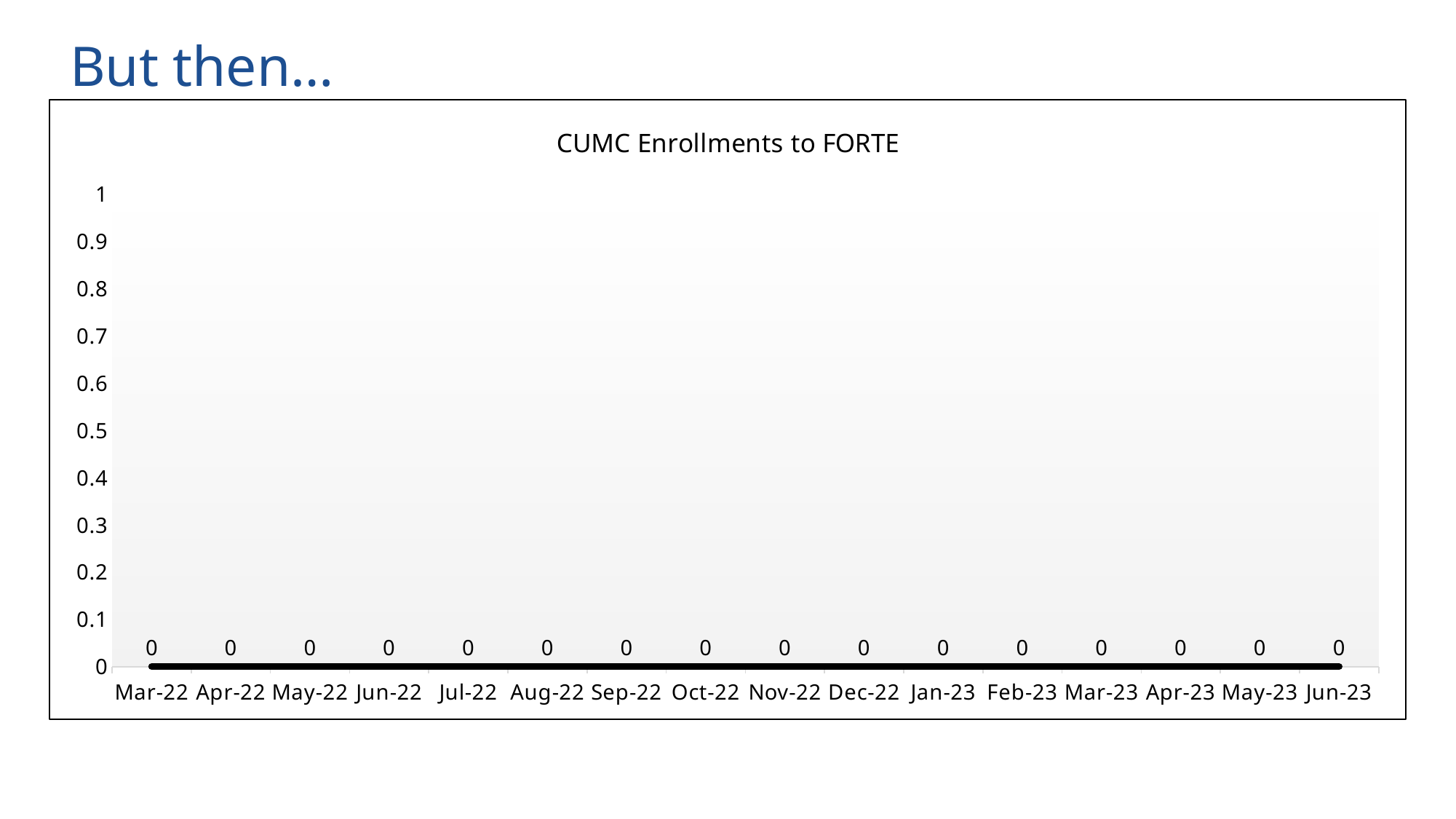
What is the value for Mar-22 in the CUMC Enrollments to FORTE chart? 0 What is the first month shown on the x axis of the CUMC Enrollments to FORTE chart? Mar-22 What is the value for Sep-22 in the CUMC Enrollments to FORTE chart? 0 What is the highest value shown on the y axis of the CUMC Enrollments to FORTE chart? 1 What is the value for Jun-23 in the CUMC Enrollments to FORTE chart? 0 What is the difference between the values for Jan-23 and Mar-22 in the CUMC Enrollments to FORTE chart? 0 How many months are plotted on the x axis of the CUMC Enrollments to FORTE chart? 16 What kind of chart is the CUMC Enrollments to FORTE chart? line chart Do the values in the CUMC Enrollments to FORTE chart rise, fall, or stay flat from Mar-22 to Jun-23? stay flat Is the value for Aug-22 in the CUMC Enrollments to FORTE chart greater or less than 0.5? less What is the title of the chart on the slide? CUMC Enrollments to FORTE What is the value for Dec-22 in the CUMC Enrollments to FORTE chart? 0